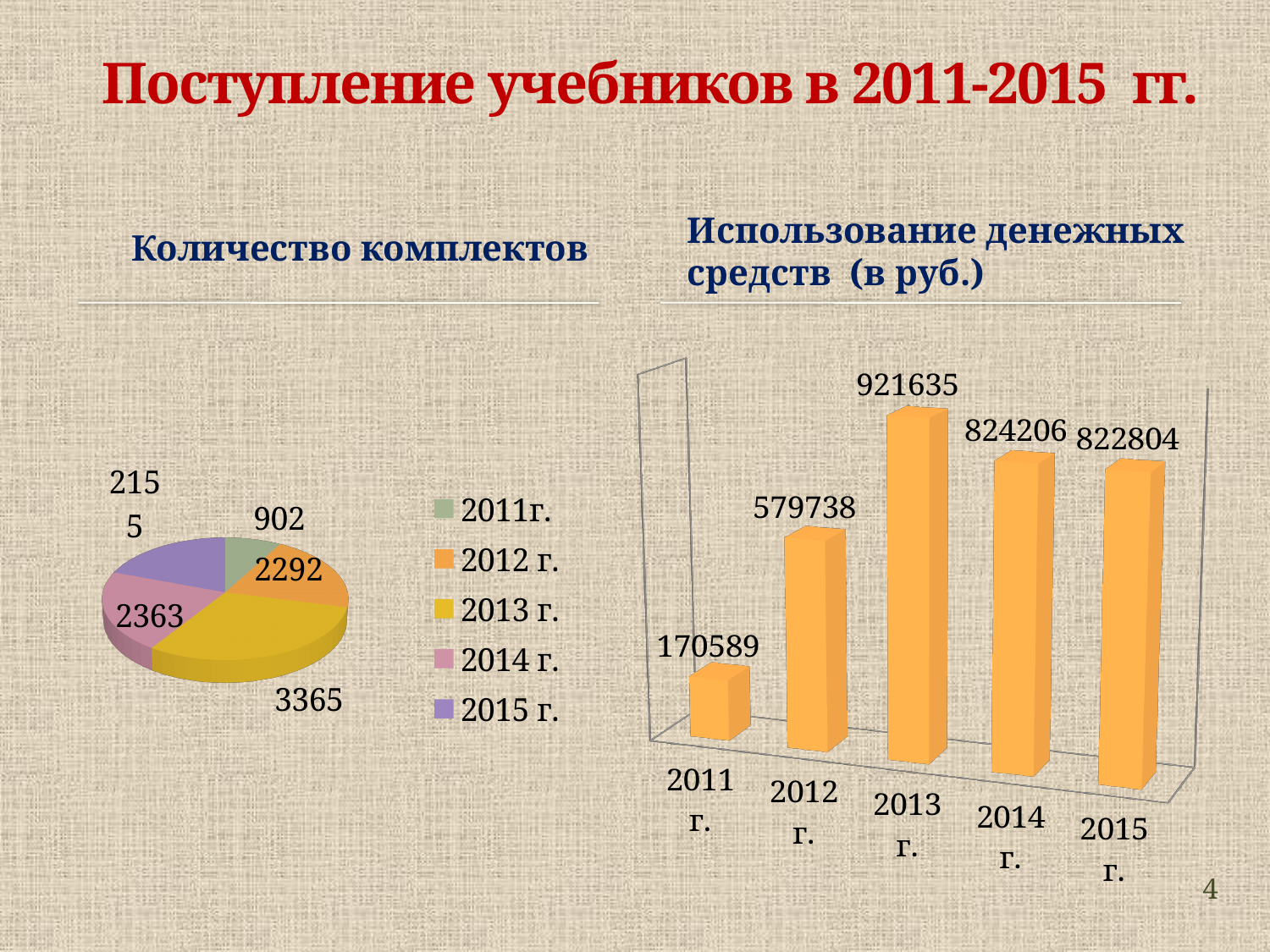
On the pie chart "Количество комплектов", which year has the largest slice? 2013 г. On the bar chart "Использование денежных средств (в руб.)", which year has the highest value? 2013 г. On the bar chart "Использование денежных средств (в руб.)", how many bars are there? 5 On the bar chart "Использование денежных средств (в руб.)", what is the value for 2011 г.? 170589 On the bar chart "Использование денежных средств (в руб.)", which year has the lowest value? 2011 г. On the bar chart "Использование денежных средств (в руб.)", what is the value for 2013 г.? 921635 On the bar chart "Использование денежных средств (в руб.)", what is the difference between the values for 2013 г. and 2014 г.? 97429 What kind of chart is the left chart, "Количество комплектов"? pie chart On the pie chart "Количество комплектов", how many entries does the legend list? 5 On the pie chart "Количество комплектов", which year has the smallest slice? 2011г. On the pie chart "Количество комплектов", what is the value for 2013 г.? 3365 On the pie chart "Количество комплектов", what is the value for 2011г.? 902